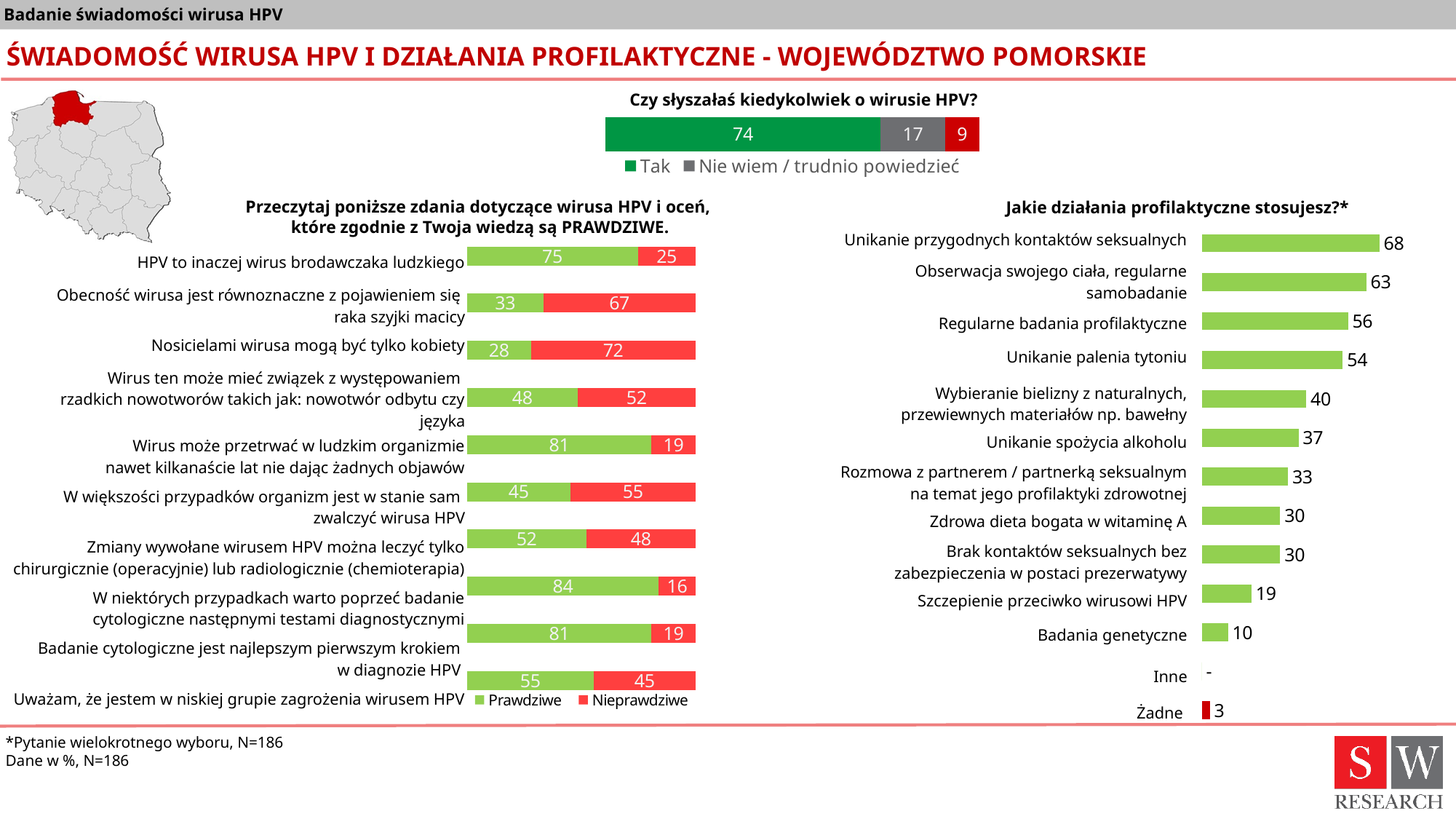
In the chart 'Przeczytaj poniższe zdania dotyczące wirusa HPV...', what is the 'Nieprawdziwe' value for 'Nosicielami wirusa mogą być tylko kobiety'? 72 What type of chart is 'Jakie działania profilaktyczne stosujesz?'? Bar chart In the chart 'Jakie działania profilaktyczne stosujesz?', what is the value for 'Żadne'? 3 In the chart 'Czy słyszałaś kiedykolwiek o wirusie HPV?', what is the value for 'Tak'? 74 In the chart 'Jakie działania profilaktyczne stosujesz?', what is the difference between 'Regularne badania profilaktyczne' and 'Szczepienie przeciwko wirusowi HPV'? 37 In the chart 'Jakie działania profilaktyczne stosujesz?', which category has the highest value? Unikanie przygodnych kontaktów seksualnych In the chart 'Jakie działania profilaktyczne stosujesz?', which is larger: 'Unikanie spożycia alkoholu' or 'Zdrowa dieta bogata w witaminę A'? Unikanie spożycia alkoholu In the chart 'Przeczytaj poniższe zdania dotyczące wirusa HPV...', what is the 'Prawdziwe' value for 'HPV to inaczej wirus brodawczaka ludzkiego'? 75 In the chart 'Jakie działania profilaktyczne stosujesz?', what is the value for 'Unikanie palenia tytoniu'? 54 In the chart 'Czy słyszałaś kiedykolwiek o wirusie HPV?', what is the value for 'Nie wiem / trudno powiedzieć'? 17 How many series does the legend of the chart 'Przeczytaj poniższe zdania dotyczące wirusa HPV...' list? 2 In the chart 'Czy słyszałaś kiedykolwiek o wirusie HPV?', what is the total of the stacked bar? 100